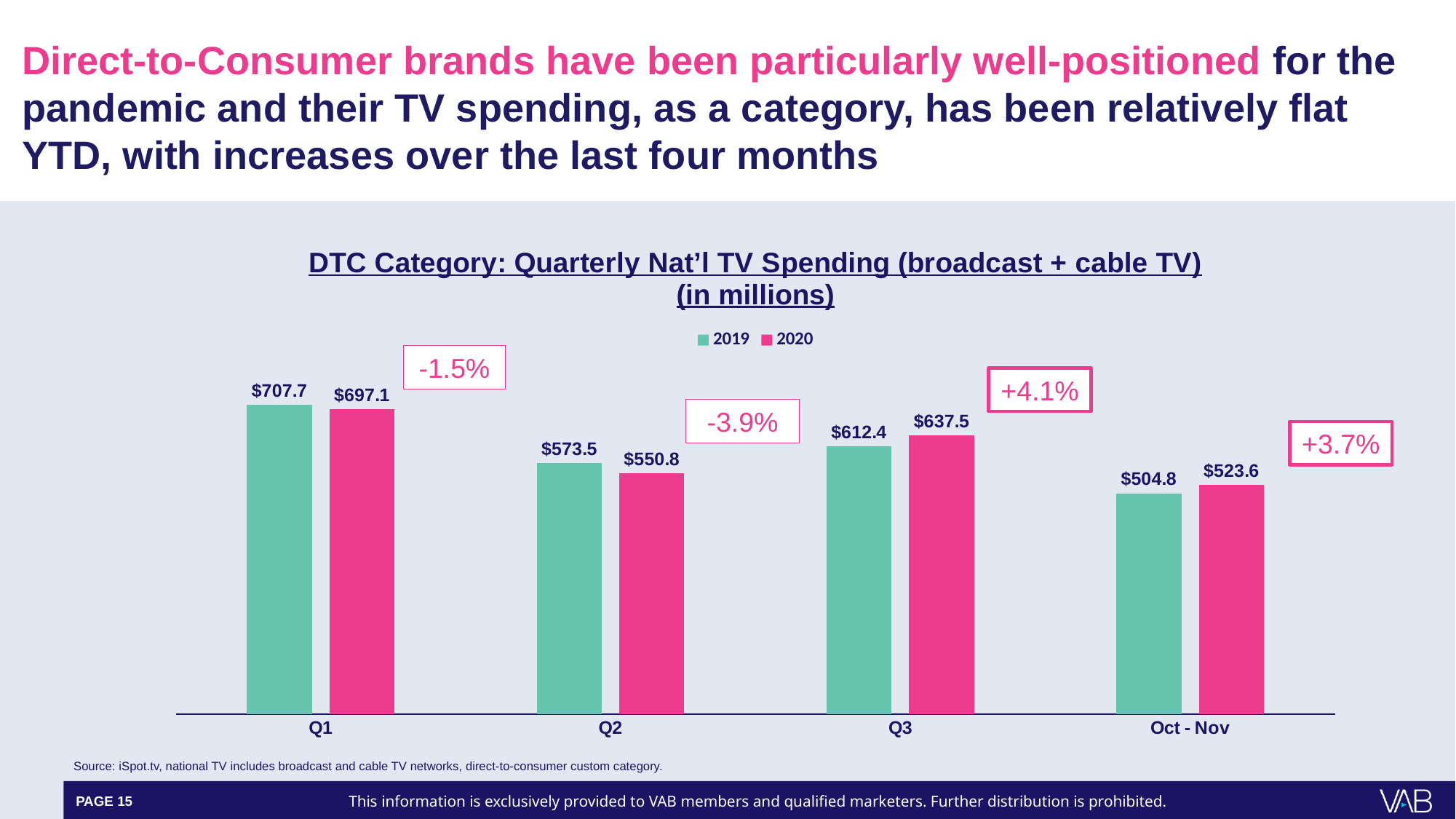
Which is larger in Q3, the 2019 value or the 2020 value? 2020 Which colour represents the 2020 series? Pink What was the 2019 DTC national TV spending in Q1? $707.7 What percentage change is shown for Q1? -1.5% What kind of chart is shown? Bar chart What is the difference between 2019 and 2020 spending in Q2? $22.7 What was the 2020 DTC national TV spending in Q3? $637.5 What was the 2020 DTC national TV spending for Oct - Nov? $523.6 Which period had the lowest 2020 spending? Oct - Nov How many periods are shown on the x axis? 4 How many series does the legend list? 2 Which period had the highest 2019 spending? Q1